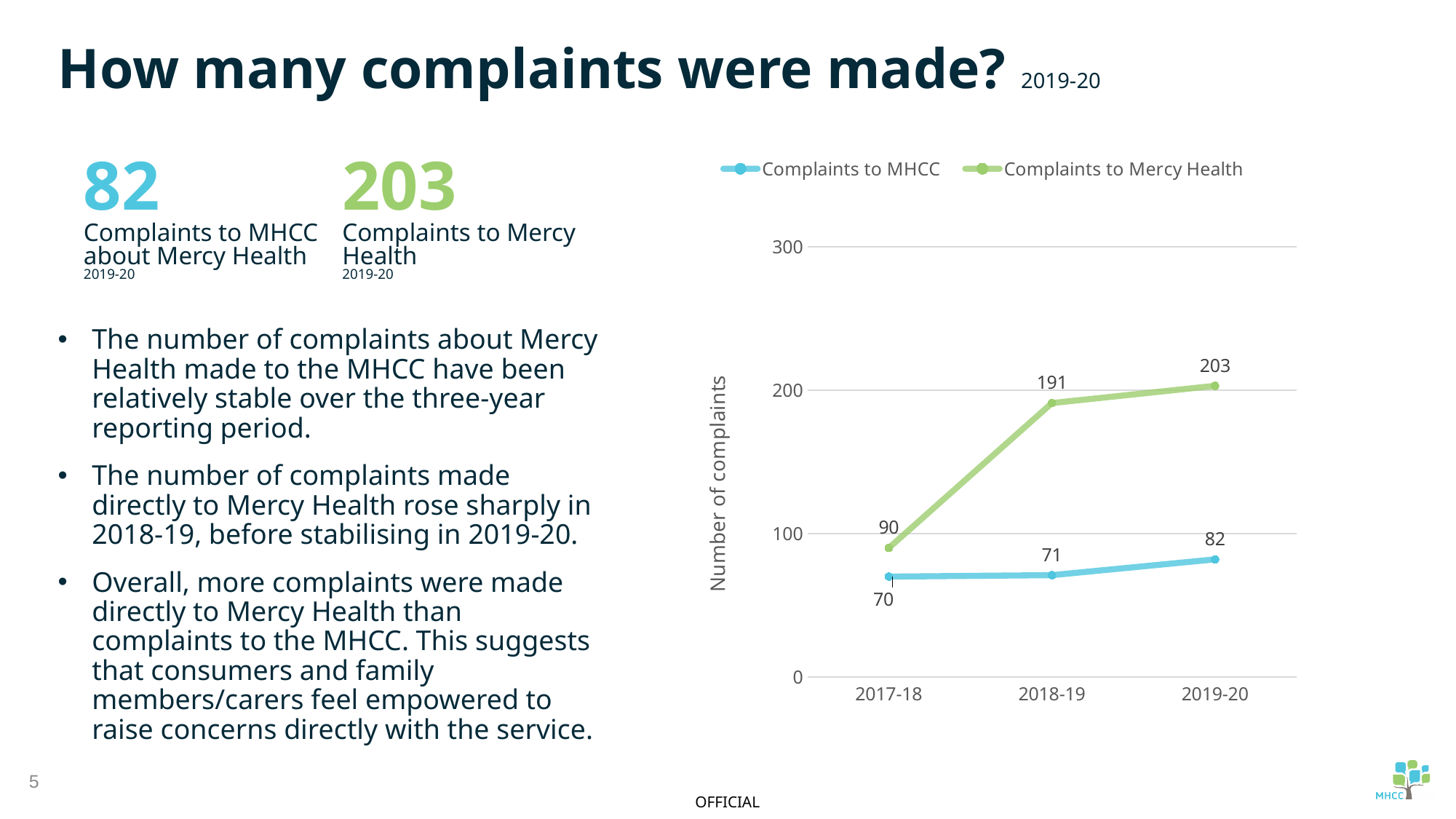
How many series does the chart legend list? 2 How many time periods are plotted on the x axis of the chart? 3 What is the difference between Complaints to Mercy Health and Complaints to MHCC in 2019-20? 121 In which year were Complaints to Mercy Health highest? 2019-20 What type of chart is shown on the slide? Line chart In which year were Complaints to MHCC lowest? 2017-18 What is the value for Complaints to MHCC in 2017-18? 70 Which is larger in 2017-18: Complaints to MHCC or Complaints to Mercy Health? Complaints to Mercy Health What is the value for Complaints to Mercy Health in 2018-19? 191 Do Complaints to Mercy Health rise or fall from 2017-18 to 2019-20? Rise What is the value for Complaints to Mercy Health in 2019-20? 203 What is the label on the vertical axis of the chart? Number of complaints